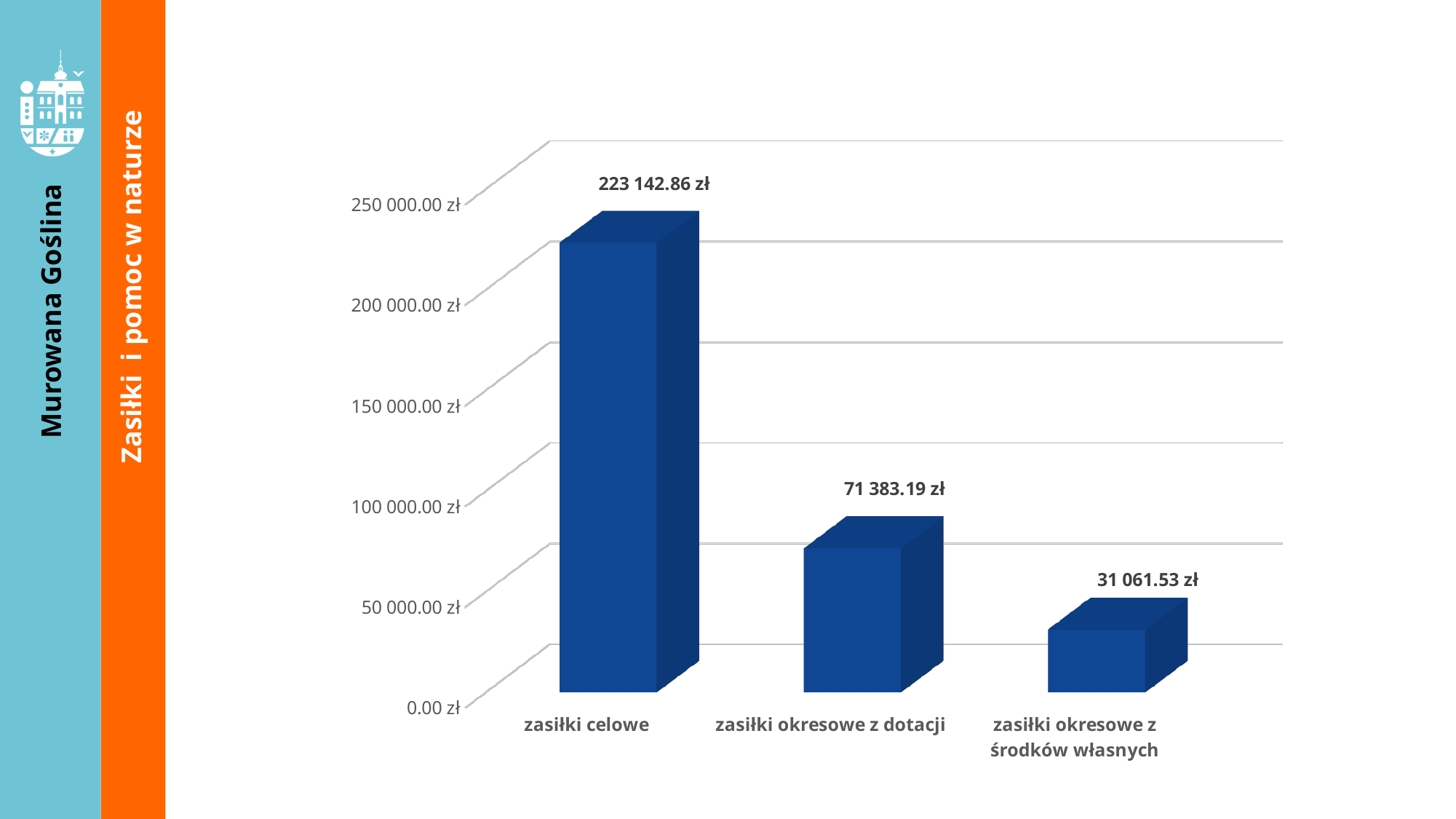
What is the value for zasiłki okresowe z dotacji? 71 383.19 zł Which category has the highest value? zasiłki celowe How many categories are shown in the chart? 3 What kind of chart is shown on the slide? bar chart Is the value for zasiłki celowe greater or less than 200 000.00 zł? greater What is the difference between the values for zasiłki celowe and zasiłki okresowe z dotacji? 151 759.67 zł What is the value for zasiłki okresowe z środków własnych? 31 061.53 zł Which category has the lowest value? zasiłki okresowe z środków własnych Do the values rise or fall from left to right across the categories? fall What is the difference between the values for zasiłki okresowe z dotacji and zasiłki okresowe z środków własnych? 40 321.66 zł What is the value for zasiłki celowe? 223 142.86 zł Which is larger, the value for zasiłki okresowe z dotacji or the value for zasiłki okresowe z środków własnych? zasiłki okresowe z dotacji